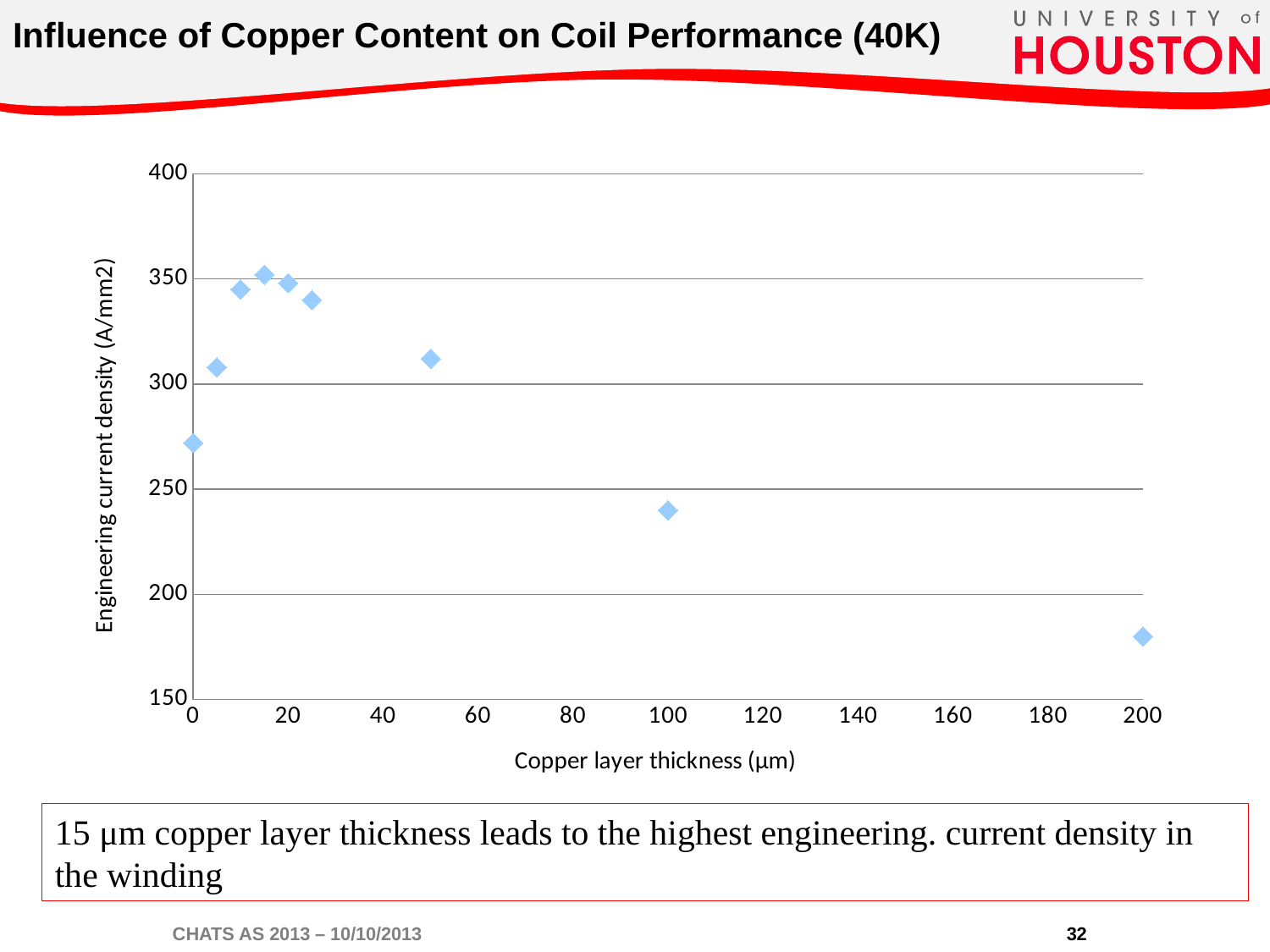
Is the engineering current density at 50 µm copper layer thickness greater or less than 300 A/mm2? greater Which has the higher engineering current density: 0 µm or 50 µm copper layer thickness? 50 µm How many data points are plotted on the chart? 9 Is the engineering current density at 200 µm copper layer thickness greater or less than 200 A/mm2? less Is the engineering current density at 0 µm copper layer thickness greater or less than 250 A/mm2? greater Do the values rise or fall as copper layer thickness increases from 50 µm to 200 µm? fall At which copper layer thickness is the engineering current density lowest? 200 µm What kind of chart is shown on the slide? scatter chart Which has the higher engineering current density: 100 µm or 200 µm copper layer thickness? 100 µm At which copper layer thickness is the engineering current density highest? 15 µm What is the label of the x axis? Copper layer thickness (µm)